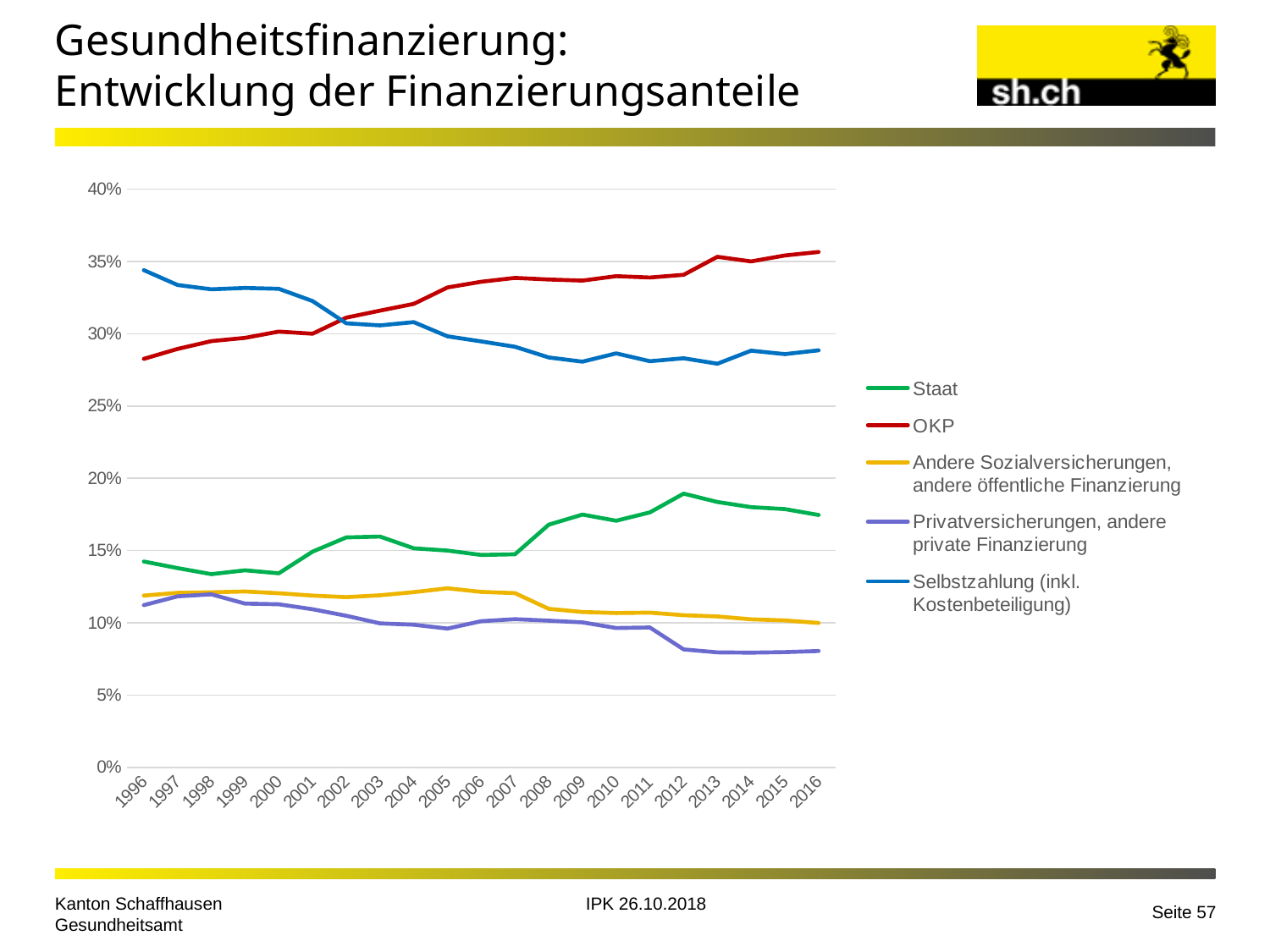
Is the value for Privatversicherungen, andere private Finanzierung in 2016 greater or less than 10%? less Which series has the highest value in 1996? Selbstzahlung (inkl. Kostenbeteiligung) How many years are shown along the x axis? 21 What colour is the Staat series line? green What kind of chart is shown on the slide? line chart How many series does the legend list? 5 Is the value for OKP in 1996 greater or less than 30%? less In 2016, which is larger: OKP or Selbstzahlung (inkl. Kostenbeteiligung)? OKP Does the Selbstzahlung (inkl. Kostenbeteiligung) series rise or fall from 1996 to 2016? fall Does the OKP series rise or fall from 1996 to 2016? rise Which series has the lowest value in 2016? Privatversicherungen, andere private Finanzierung Which series has the highest value in 2016? OKP